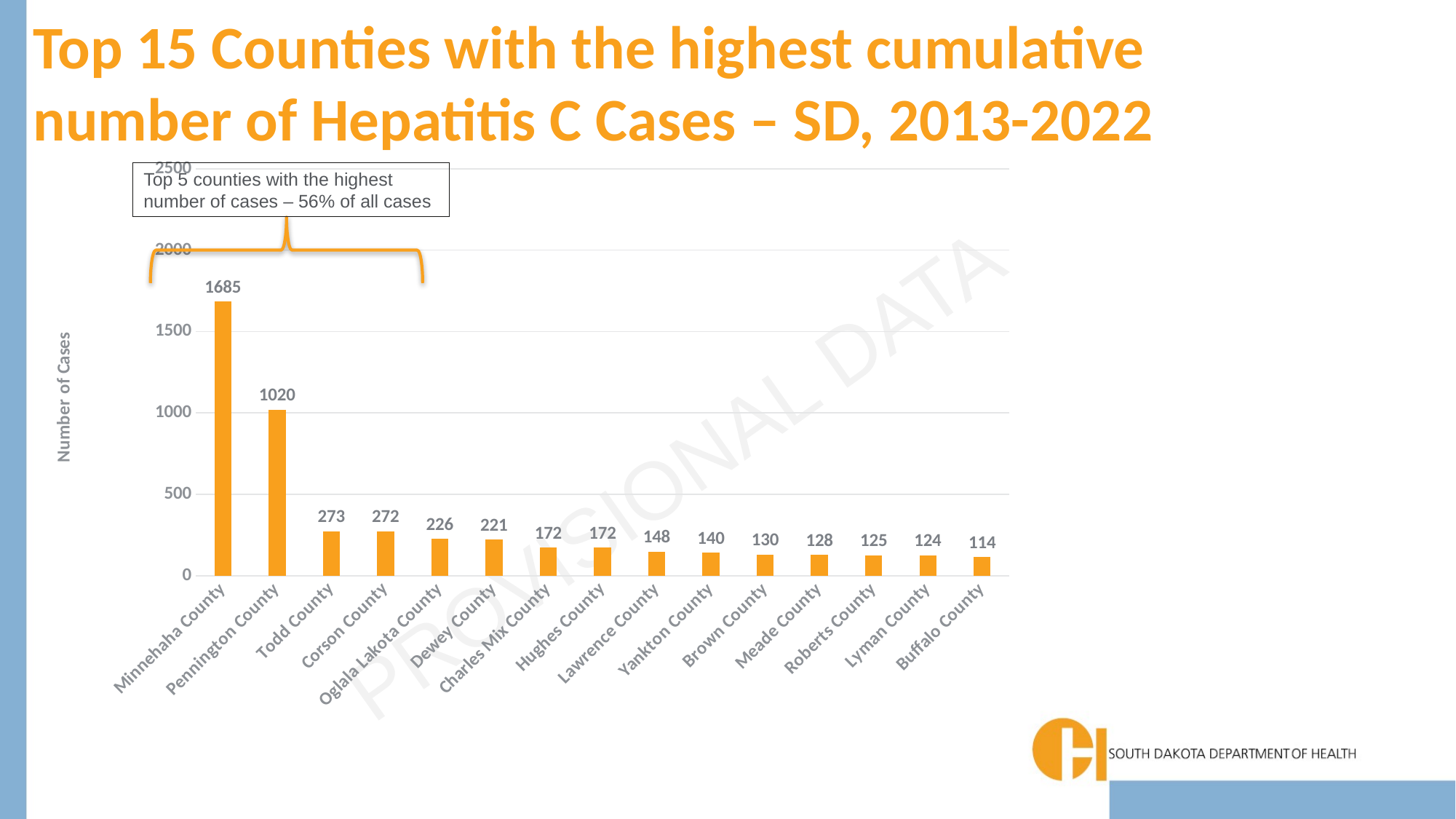
What is the number of Hepatitis C cases for Minnehaha County? 1685 Which county has the highest number of cases? Minnehaha County According to the annotation, what share of all cases do the top 5 counties account for? 56% What is the difference in cases between Minnehaha County and Pennington County? 665 What kind of chart is shown on the slide? Bar chart Which county has the lowest number of cases among those shown? Buffalo County What is the number of cases shown for Oglala Lakota County? 226 What is the number of Hepatitis C cases for Pennington County? 1020 What is the difference in cases between Todd County and Dewey County? 52 How many counties are shown on the chart? 15 What is the number of cases shown for Buffalo County? 114 Which has more cases, Lawrence County or Yankton County? Lawrence County